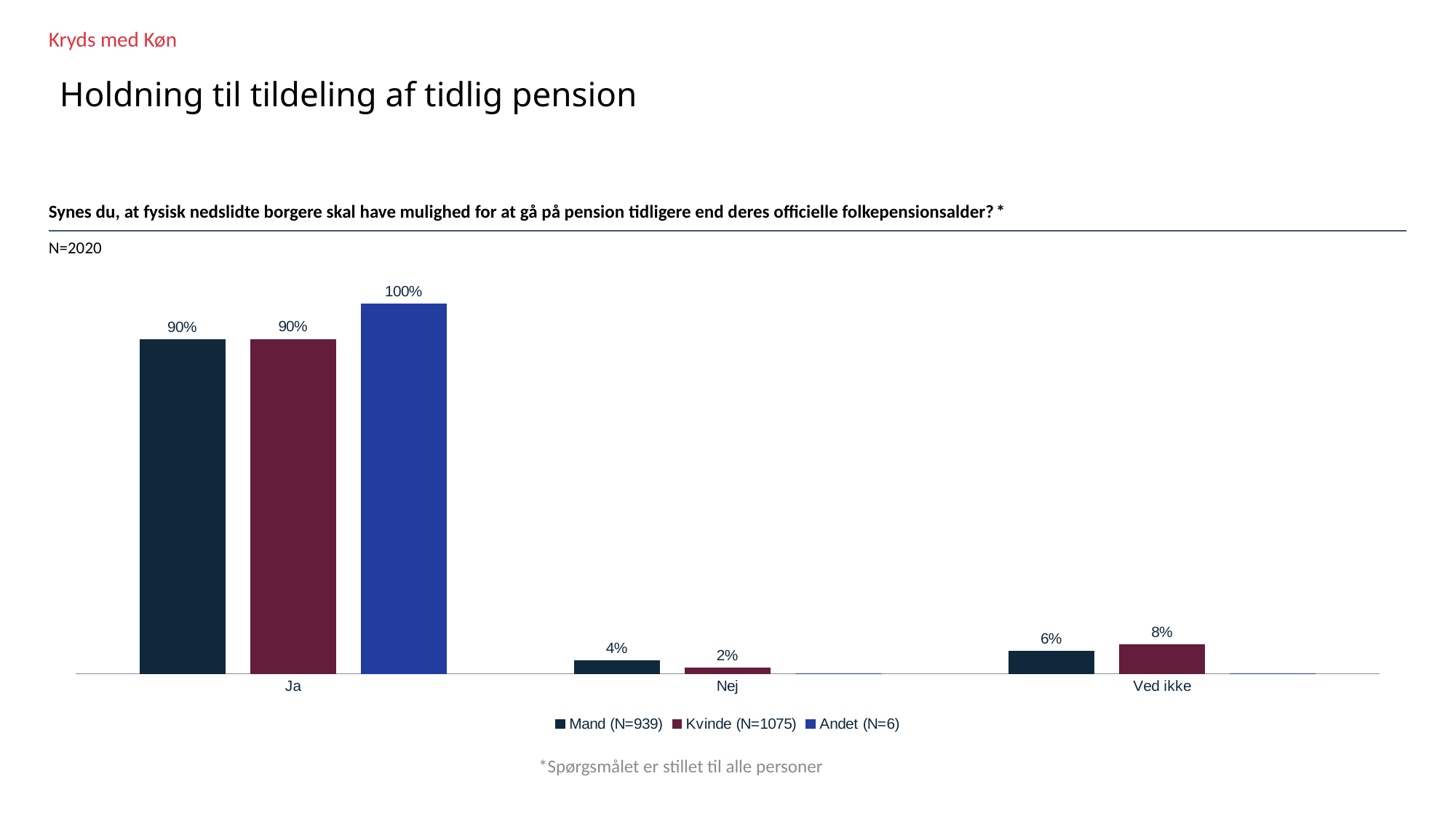
What kind of chart is shown on the slide? Bar chart What is the value for Mand (N=939) in the Ved ikke category? 6% Which series has the highest value in the Ja category? Andet (N=6) How many categories are shown on the x axis? 3 What is the value for Andet (N=6) in the Ja category? 100% What is the value for Mand (N=939) in the Ja category? 90% Which is larger in the Nej category: Mand (N=939) or Kvinde (N=1075)? Mand (N=939) What is the value for Kvinde (N=1075) in the Ved ikke category? 8% What is the value for Kvinde (N=1075) in the Nej category? 2% What is the difference between the Mand (N=939) and Kvinde (N=1075) values in the Ved ikke category? 2% How many series does the legend list? 3